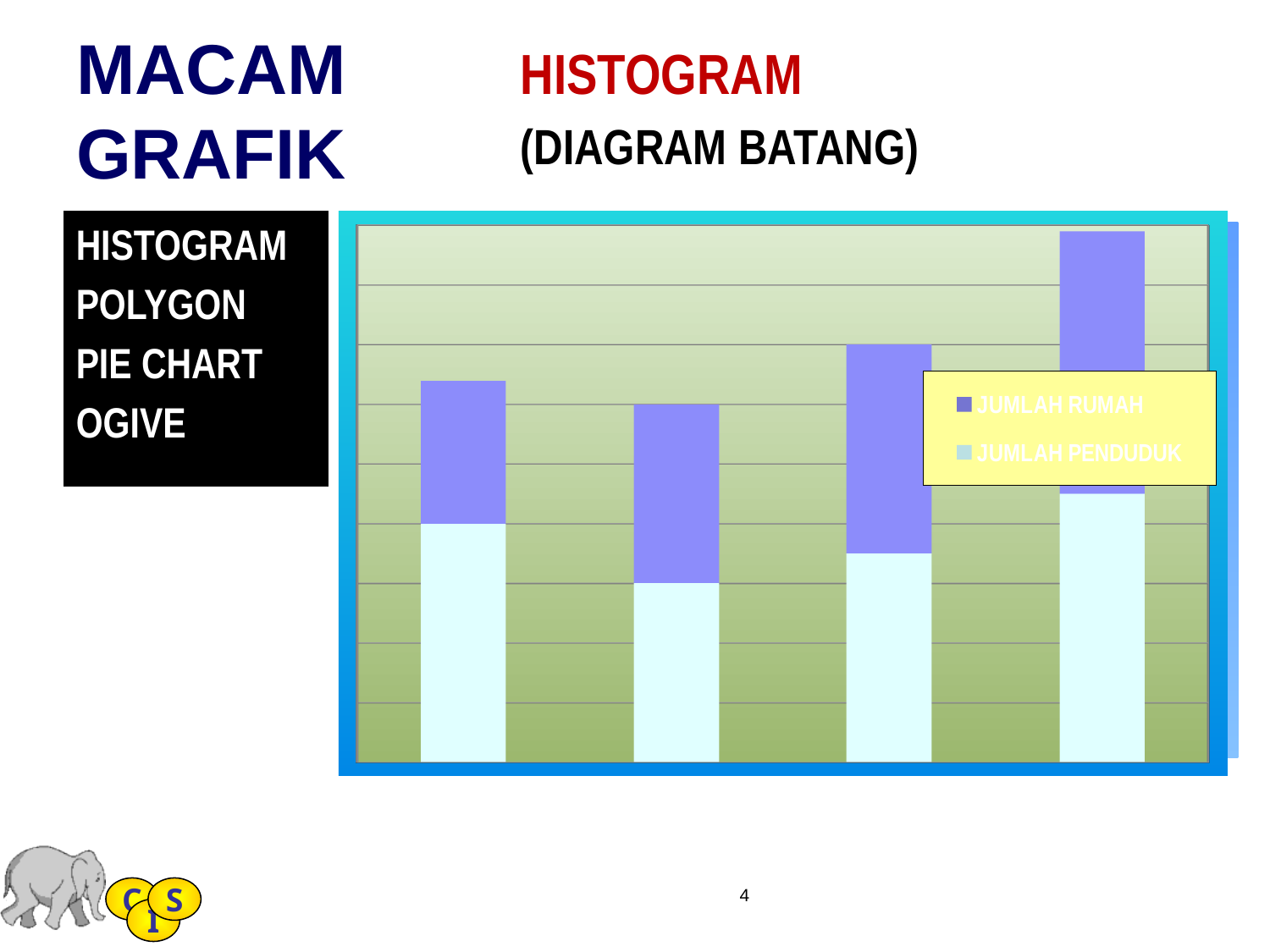
Which bar has the smallest JUMLAH PENDUDUK (light cyan) segment? The second bar Which is taller overall, the first bar or the fourth bar? The fourth bar Do the bar heights rise steadily from left to right across the chart? No Which bar, counted from the left, is the shortest overall? The second bar Which is taller overall, the second bar or the third bar? The third bar Which series is shown in the light cyan colour at the bottom of each bar? JUMLAH PENDUDUK What are the two series named in the chart's legend? JUMLAH RUMAH and JUMLAH PENDUDUK How many series does the chart's legend list? 2 Which bar, counted from the left, is the tallest overall? The fourth (rightmost) bar How many bars are plotted in the chart? 4 What kind of chart is shown on the slide? Stacked bar chart Which bar has the largest JUMLAH PENDUDUK (light cyan) segment? The fourth (rightmost) bar